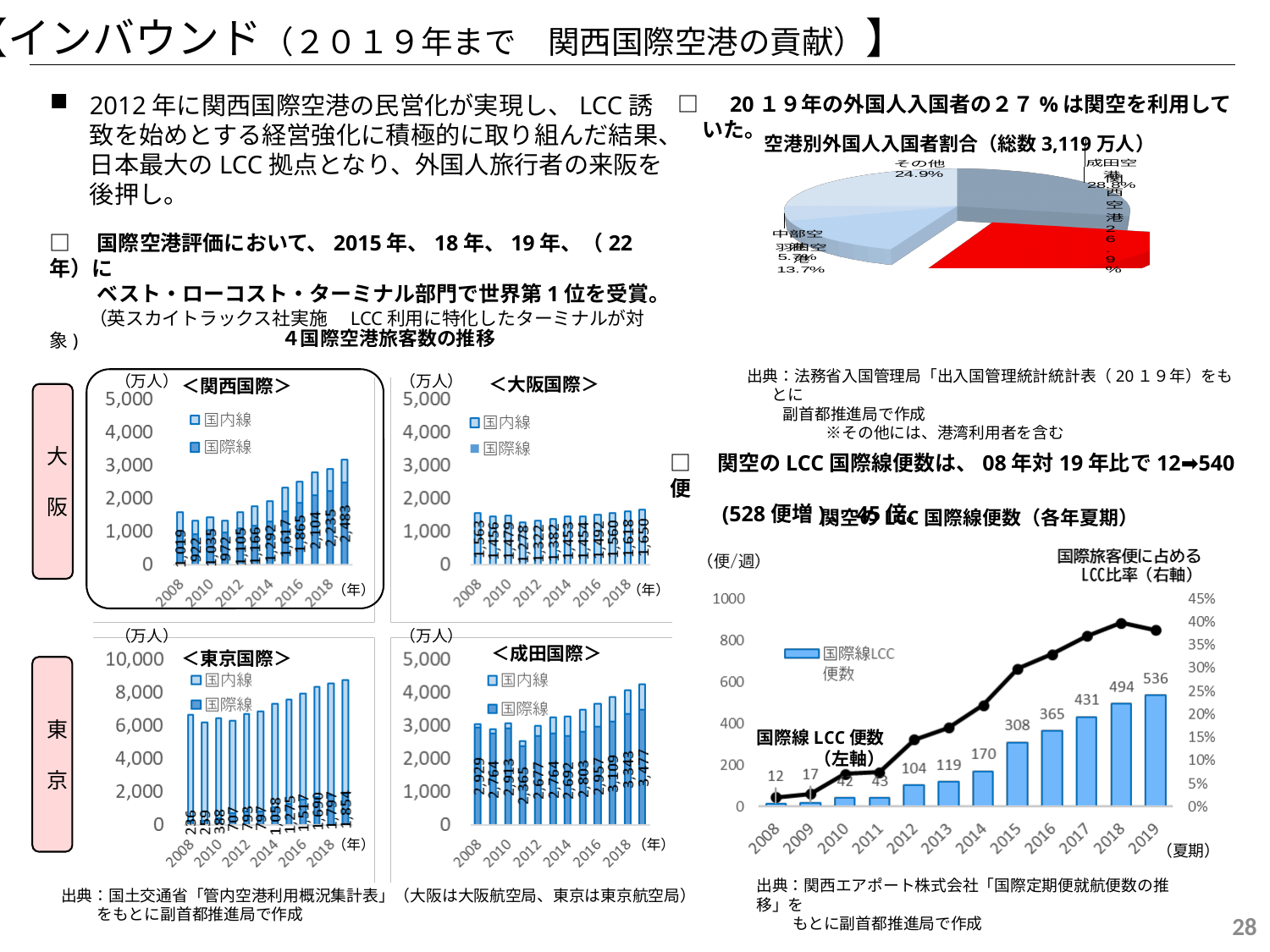
In the 空港別外国人入国者割合 pie chart, what share is labelled for その他? 24.9% In the 成田国際 chart, what is the 国際線 value for 2019? 3,477 In the 関空のLCC国際線便数 chart, what is the value for 2019? 536 In the 東京国際 chart, what is the 国際線 value for 2008? 236 In the 関空のLCC国際線便数 chart, do the bar values rise or fall from 2008 to 2019? rise In the 関空のLCC国際線便数 chart, how many years are shown on the x axis? 12 In the 関空のLCC国際線便数 chart, what is the value for 2008? 12 In the 成田国際 chart, which is larger, the 国際線 value for 2011 or for 2019? 2019 In the 関西国際 chart, which year has the lowest 国際線 value? 2009 In the 関西国際 chart, what is the 国際線 value for 2019? 2,483 In the 関空のLCC国際線便数 chart, which year has the highest bar? 2019 In the 関空のLCC国際線便数 chart, what is the difference between the 2019 value and the 2018 value? 42